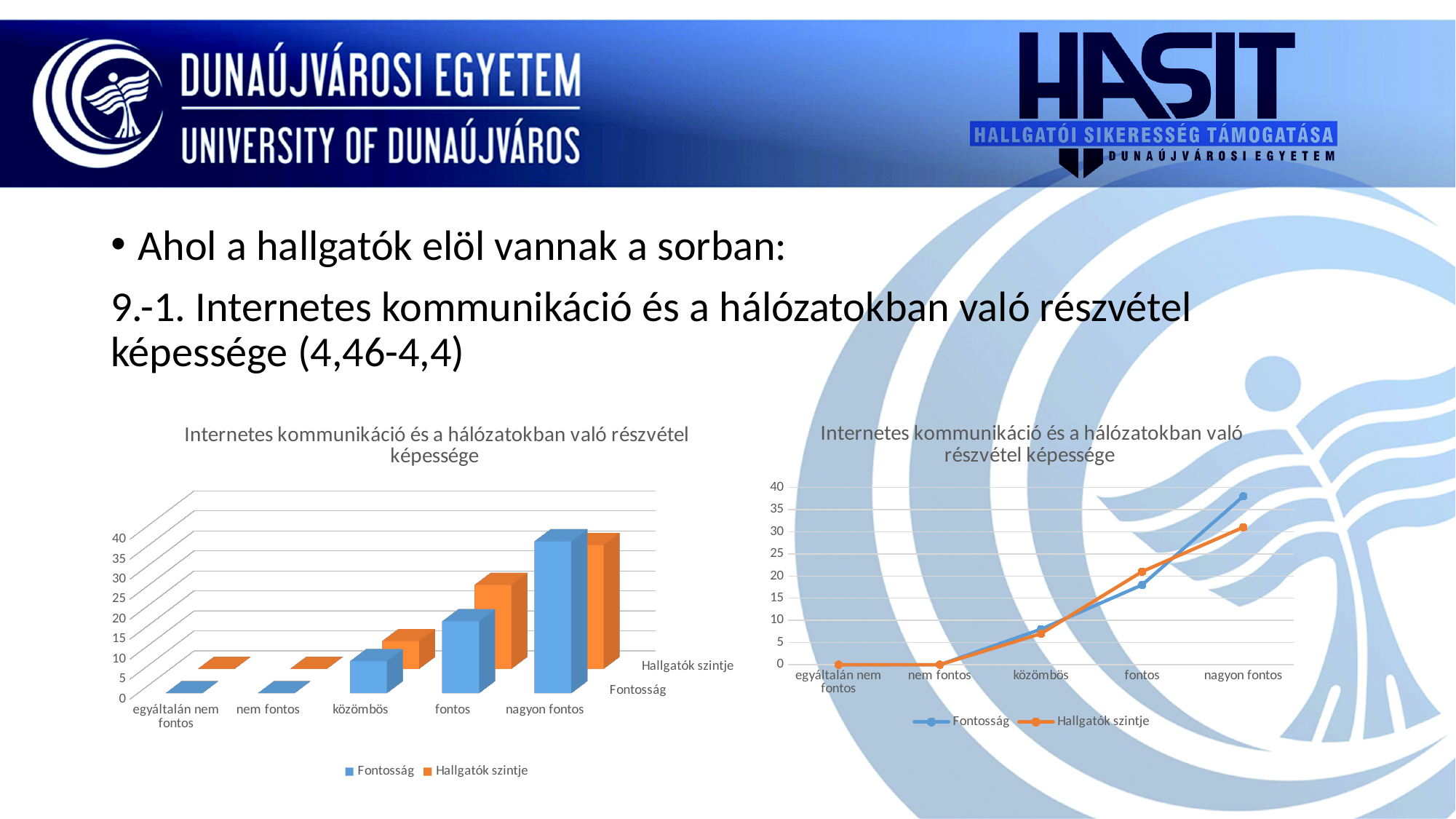
What kind of chart is the chart on the left of the slide? bar chart In the left-hand bar chart, which series has the larger value for fontos, Fontosság or Hallgatók szintje? Hallgatók szintje In the right-hand line chart, is the value of Fontosság for nagyon fontos greater or less than 35? greater In the right-hand line chart, which category has the highest value for Fontosság? nagyon fontos In the right-hand line chart, which series has the larger value for nagyon fontos, Fontosság or Hallgatók szintje? Fontosság In the left-hand bar chart, which colour represents the Hallgatók szintje series? orange In the right-hand line chart, is the value of Hallgatók szintje for fontos greater or less than 15? greater In the right-hand line chart, what is the value of Fontosság for nem fontos? 0 In the left-hand bar chart, how many categories are shown on the x axis? 5 In the right-hand line chart, how many series does the legend list? 2 In the right-hand line chart, do the values of Hallgatók szintje rise or fall from közömbös to nagyon fontos? rise What kind of chart is the chart on the right of the slide? line chart